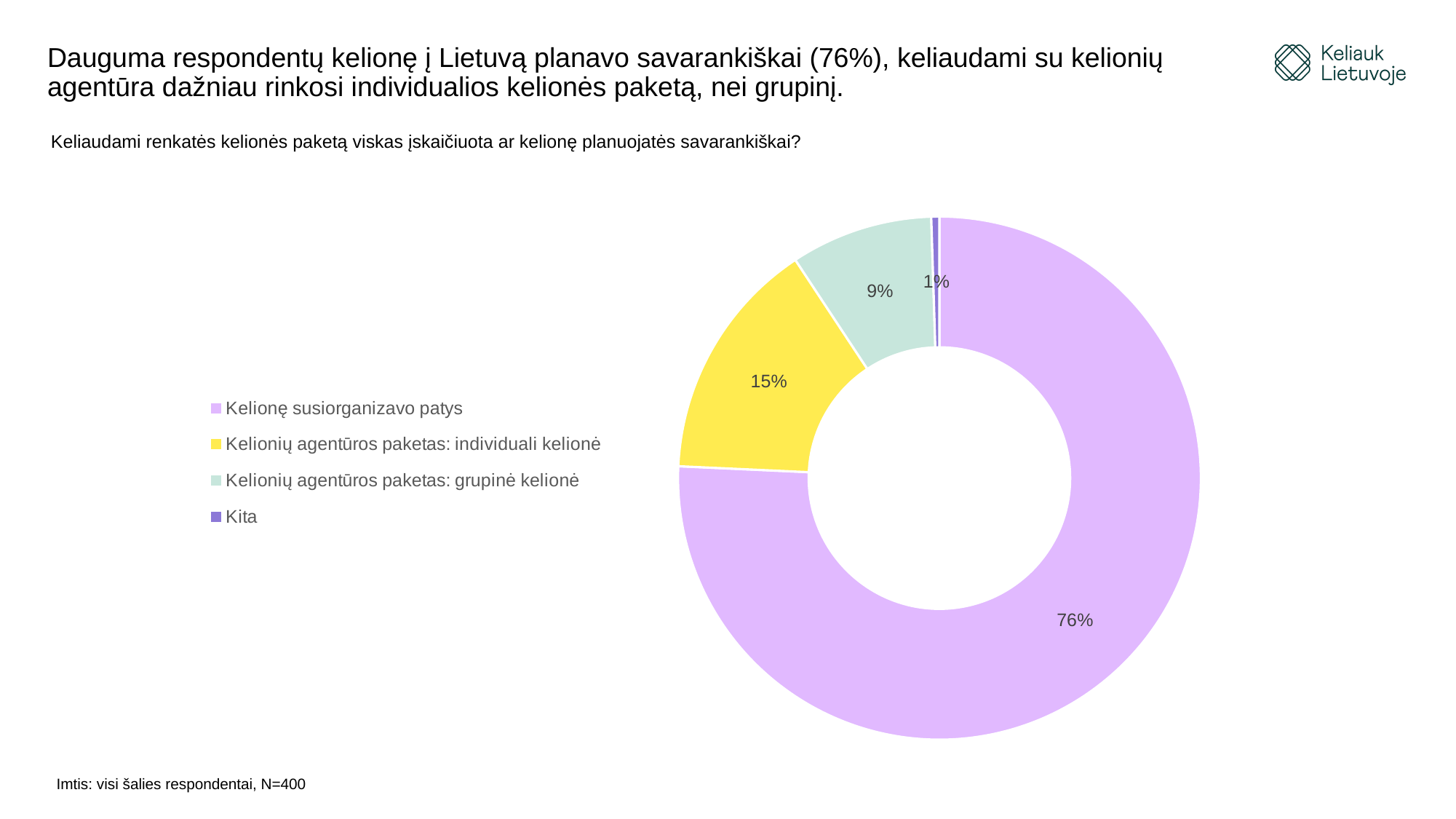
What colour is the slice for "Kelionių agentūros paketas: individuali kelionė"? Yellow What is the difference in percentage points between "Kelionių agentūros paketas: individuali kelionė" and "Kelionių agentūros paketas: grupinė kelionė"? 6 percentage points What percentage is shown for "Kita"? 1% Which category has the smallest share of the chart? Kita Which is larger: the share for "Kelionių agentūros paketas: individuali kelionė" or for "Kelionių agentūros paketas: grupinė kelionė"? Kelionių agentūros paketas: individuali kelionė What is the combined share of the two travel agency package categories? 24% How many categories does the chart show? 4 Which category has the largest share of the chart? Kelionę susiorganizavo patys What kind of chart is shown on the slide? Pie (doughnut) chart What share of respondents is shown for "Kelionę susiorganizavo patys"? 76% What percentage is shown for "Kelionių agentūros paketas: grupinė kelionė"? 9% What percentage is shown for "Kelionių agentūros paketas: individuali kelionė"? 15%